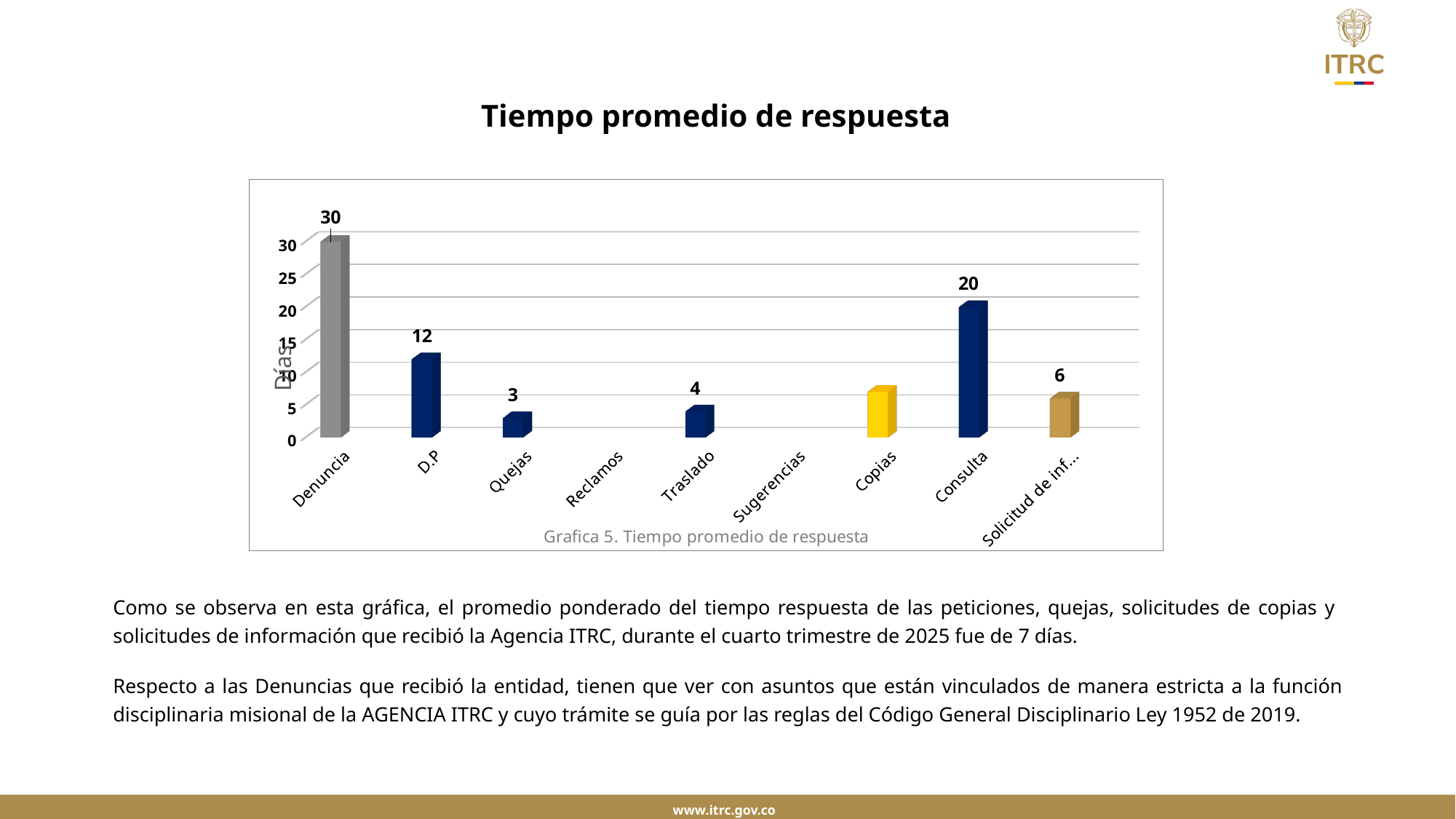
How many categories are shown on the x axis? 9 What is the value for D.P? 12 What is the label of the vertical axis? Días What is the value for Consulta? 20 Which category has the highest value? Denuncia What is the difference between the values for Denuncia and Consulta? 10 Among the categories with a printed data label, which has the lowest value? Quejas Is the value for Copias greater or less than 10? less What is the value for Denuncia? 30 What is the value for Traslado? 4 What kind of chart is shown? bar chart Which is larger, the value for D.P or the value for Consulta? Consulta